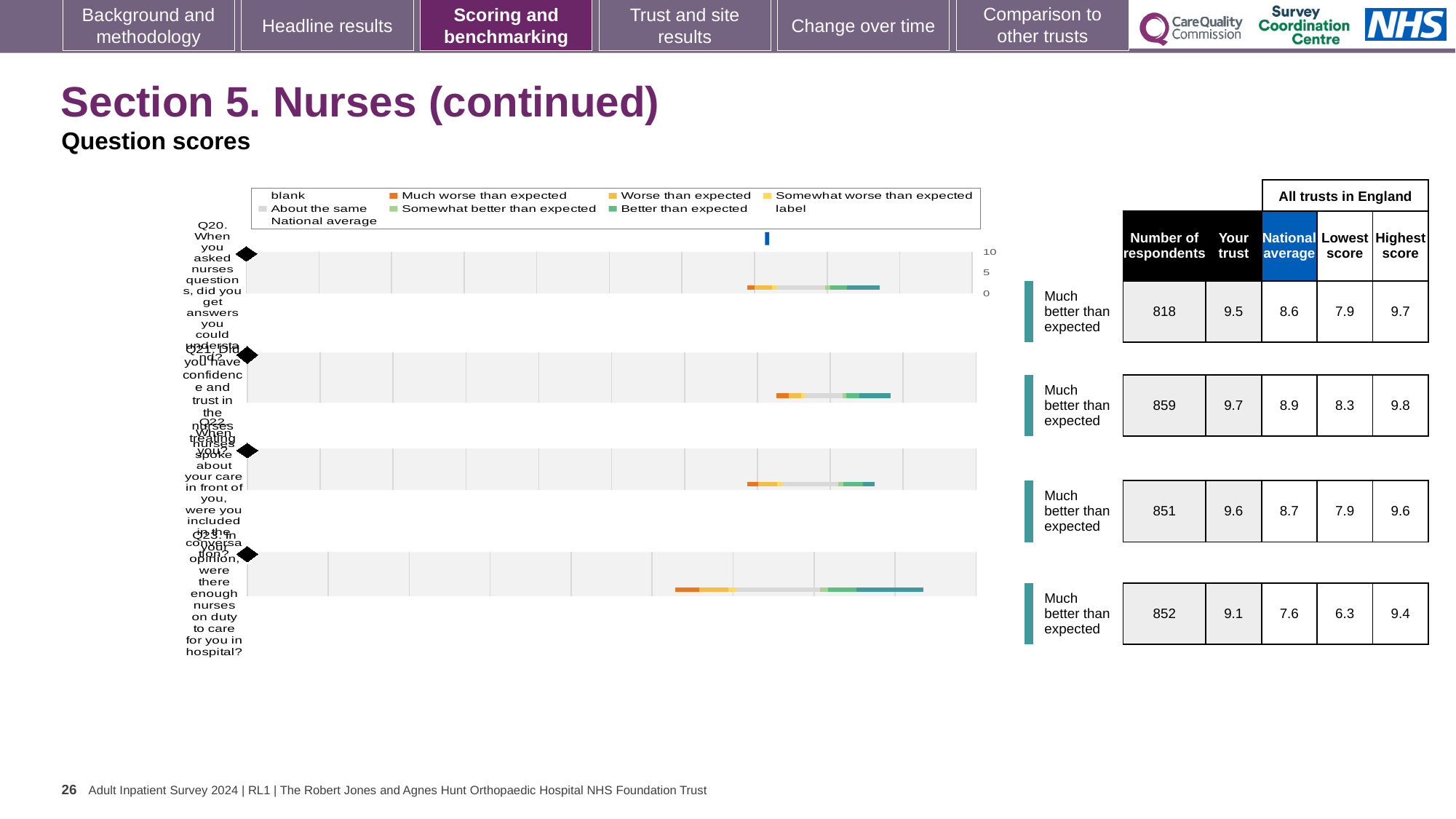
Which question has the highest 'Your trust' score in the table? Q21 Which question has the lowest 'Your trust' score in the table? Q23 According to the table, what is the 'Your trust' score for Q23? 9.1 How many questions (categories) are plotted in the chart? 4 For Q23, what is the difference between the 'Your trust' score and the national average? 1.5 For Q20, which is larger: the 'Your trust' score or the national average? Your trust How many respondents are listed for Q22? 851 According to the table, what is the national average for Q21? 8.9 How many entries does the chart legend list? 9 What kind of chart is shown on the slide? bar chart What colour does the legend use for 'Much worse than expected'? orange What benchmark category is shown for all four questions on the slide? Much better than expected